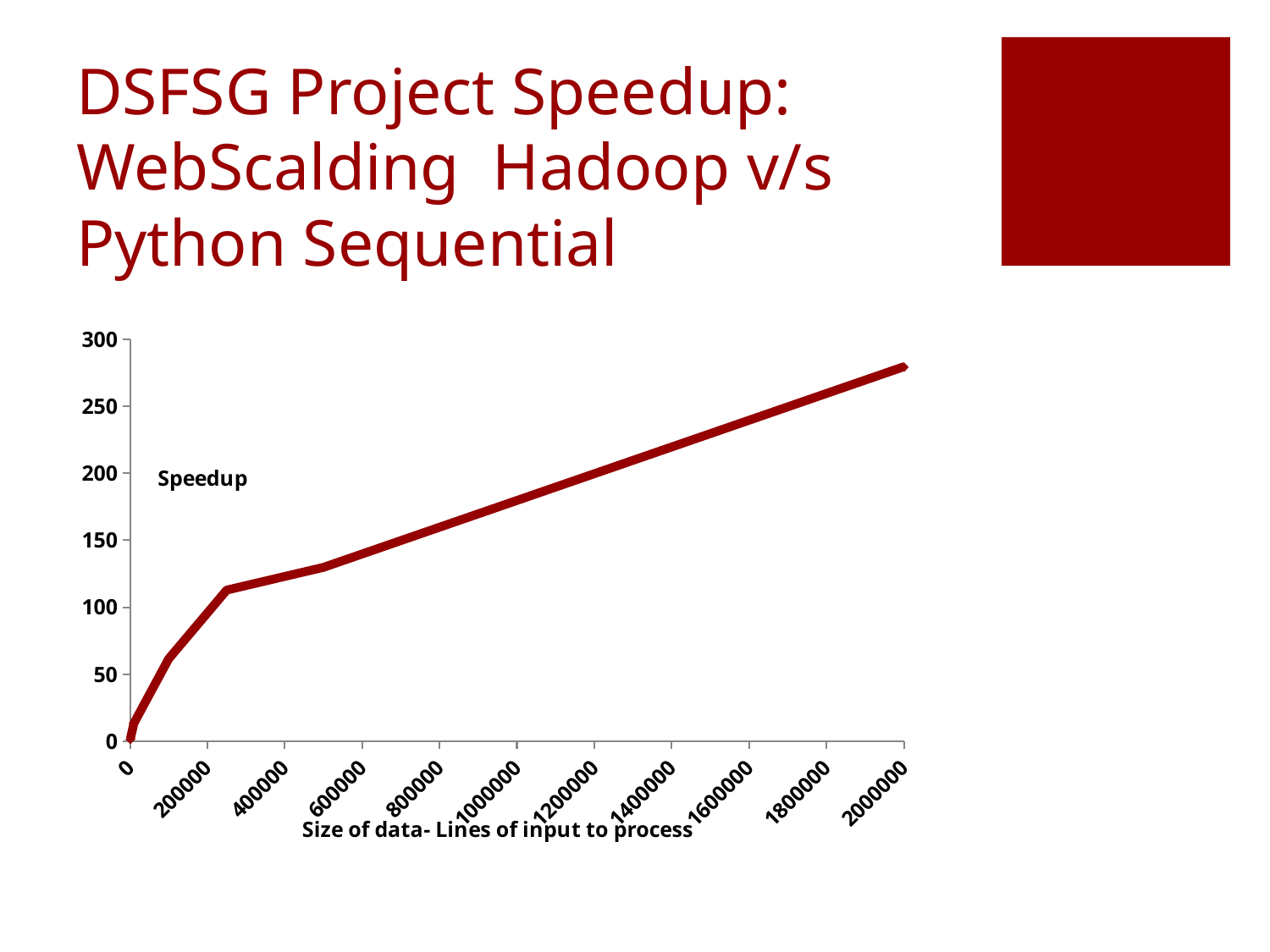
Is the speedup value at 1000000 lines of input greater or less than 200? less Is the speedup value at 0 lines of input greater or less than 50? less Which has the larger speedup: 200000 lines of input or 1800000 lines of input? 1800000 Is the speedup value at 2000000 lines of input greater or less than 250? greater Does the speedup rise or fall as the size of data increases along the x axis? rise What label is shown next to the plotted line? Speedup What kind of chart is shown on the slide? line chart What is the label of the x axis? Size of data- Lines of input to process